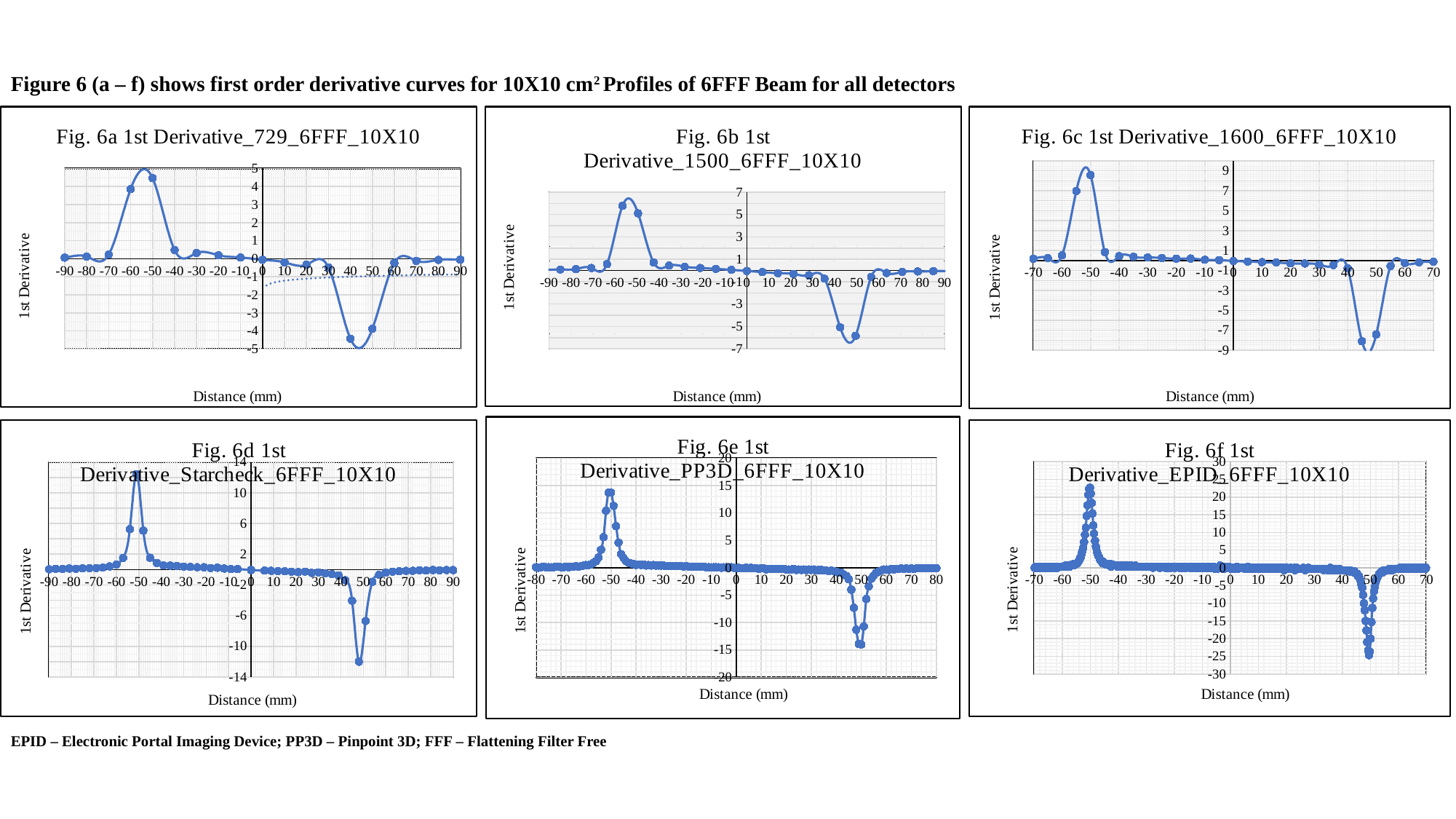
In Fig. 6d 1st Derivative_Starcheck_6FFF_10X10, is the lowest value near 50 mm greater or less than -10? less In Fig. 6c 1st Derivative_1600_6FFF_10X10, is the peak value near -50 mm greater or less than 7? greater How many charts are shown on the slide? 6 In Fig. 6b 1st Derivative_1500_6FFF_10X10, which is larger: the value at -50 mm or the value at 50 mm? the value at -50 mm In Fig. 6e 1st Derivative_PP3D_6FFF_10X10, is the peak value near -50 mm greater or less than 10? greater In Fig. 6a 1st Derivative_729_6FFF_10X10, does the curve rise or fall between -70 mm and -60 mm? rise What kind of chart is Fig. 6a 1st Derivative_729_6FFF_10X10? line chart What is the x-axis title of Fig. 6c 1st Derivative_1600_6FFF_10X10? Distance (mm) What is the y-axis title of Fig. 6d 1st Derivative_Starcheck_6FFF_10X10? 1st Derivative